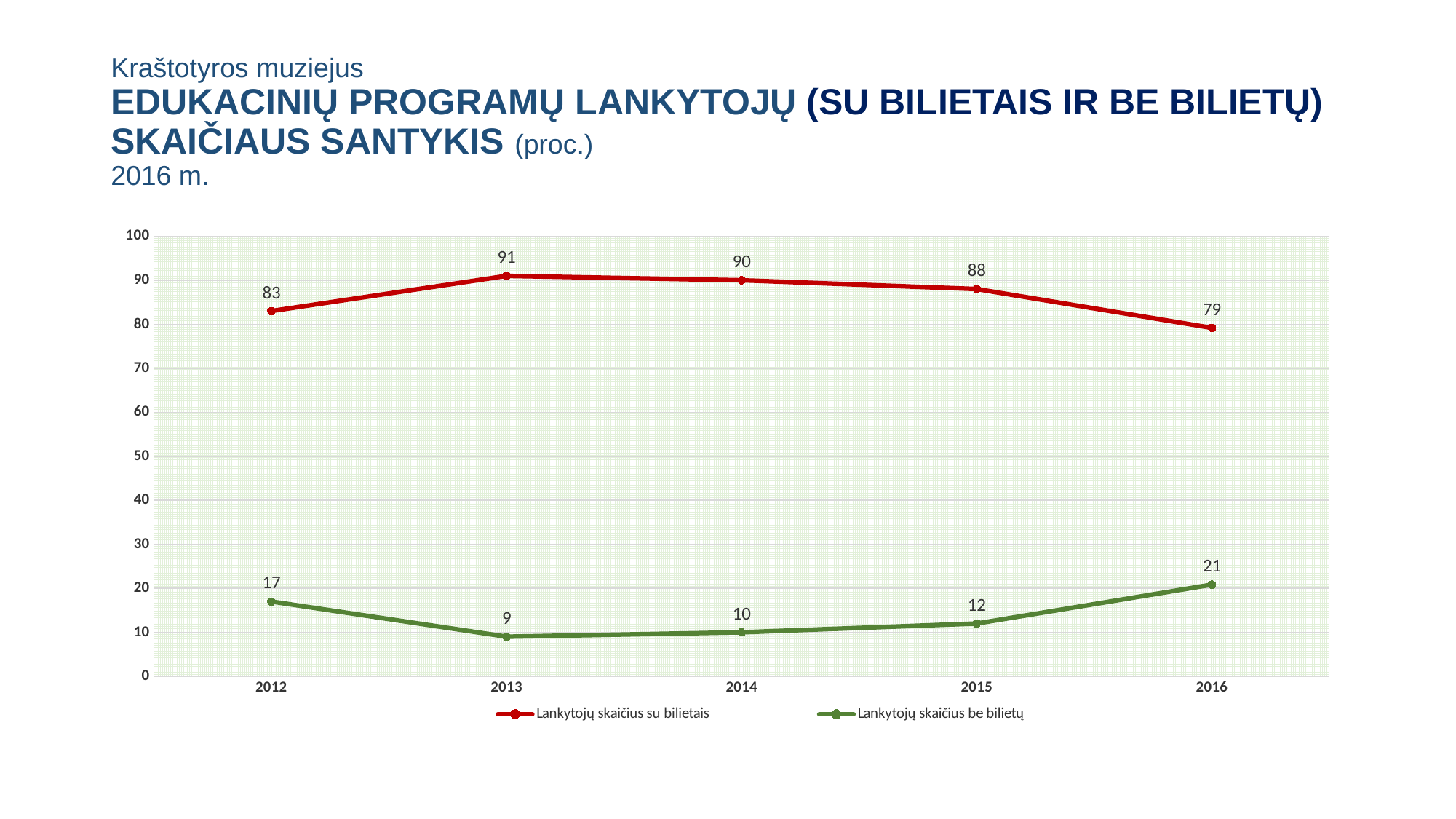
In which year is 'Lankytojų skaičius be bilietų' lowest? 2013 What is the difference between 'Lankytojų skaičius su bilietais' and 'Lankytojų skaičius be bilietų' in 2012? 66 What is the value for 'Lankytojų skaičius su bilietais' in 2013? 91 In which year is 'Lankytojų skaičius su bilietais' highest? 2013 What is the value for 'Lankytojų skaičius be bilietų' in 2016? 21 Is the value for 'Lankytojų skaičius su bilietais' in 2016 greater or less than 80? less How many years are shown on the x axis? 5 Does 'Lankytojų skaičius su bilietais' rise or fall from 2013 to 2016? fall Which is larger: 'Lankytojų skaičius be bilietų' in 2012 or in 2015? 2012 What is the value for 'Lankytojų skaičius be bilietų' in 2013? 9 How many series does the legend list? 2 What kind of chart is shown on the slide? line chart